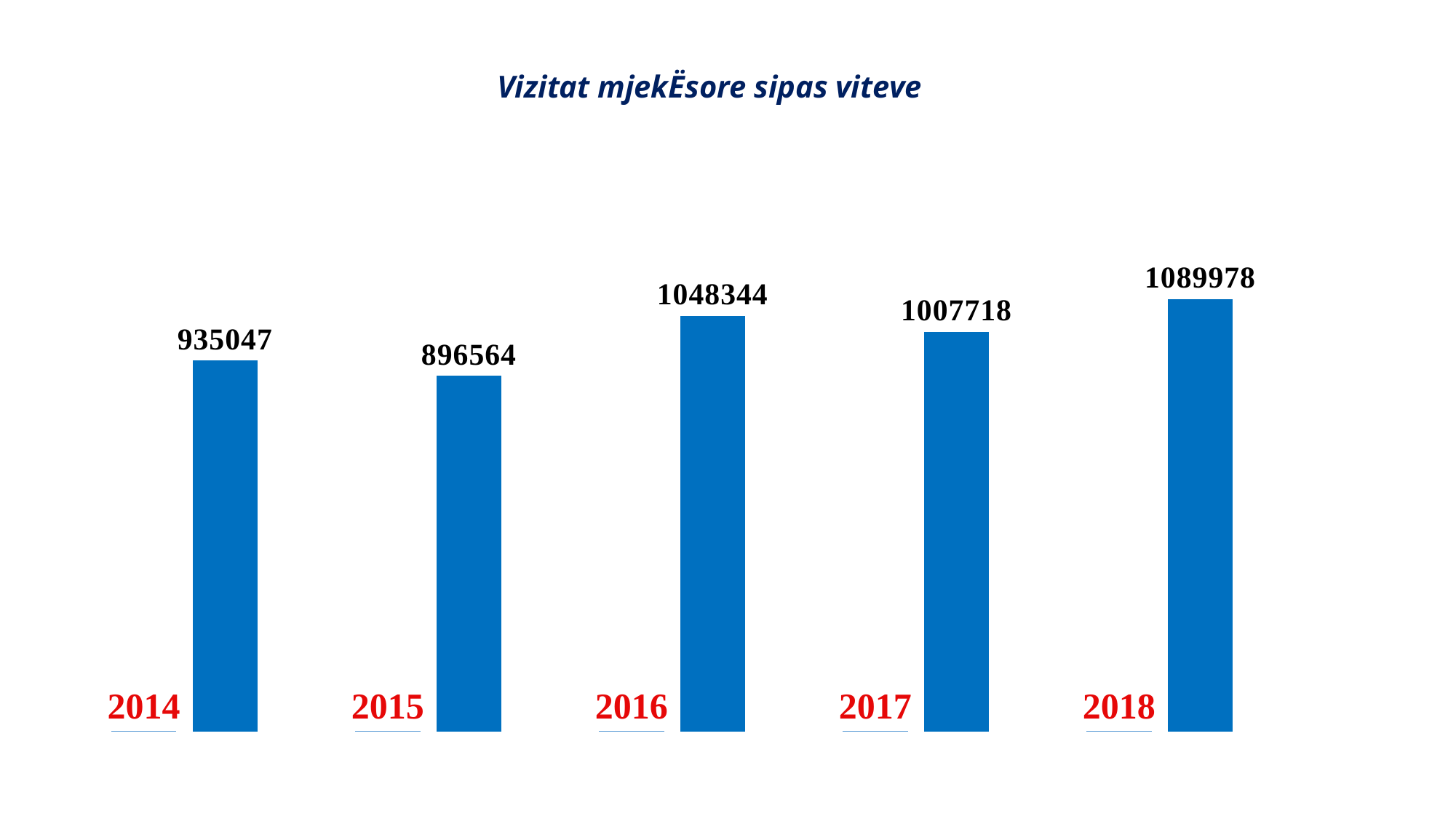
What kind of chart is shown on the slide? Bar chart What is the value for 2016? 1048344 What is the value for 2014? 935047 What is the difference between the values for 2016 and 2015? 151780 Which year has the highest value? 2018 What is the value for 2018? 1089978 What is the title of the chart? Vizitat mjekËsore sipas viteve What is the difference between the values for 2018 and 2014? 154931 How many years are shown on the chart? 5 Did the value rise or fall from 2016 to 2017? Fall Which is larger, the value for 2016 or the value for 2017? 2016 Which year has the lowest value? 2015